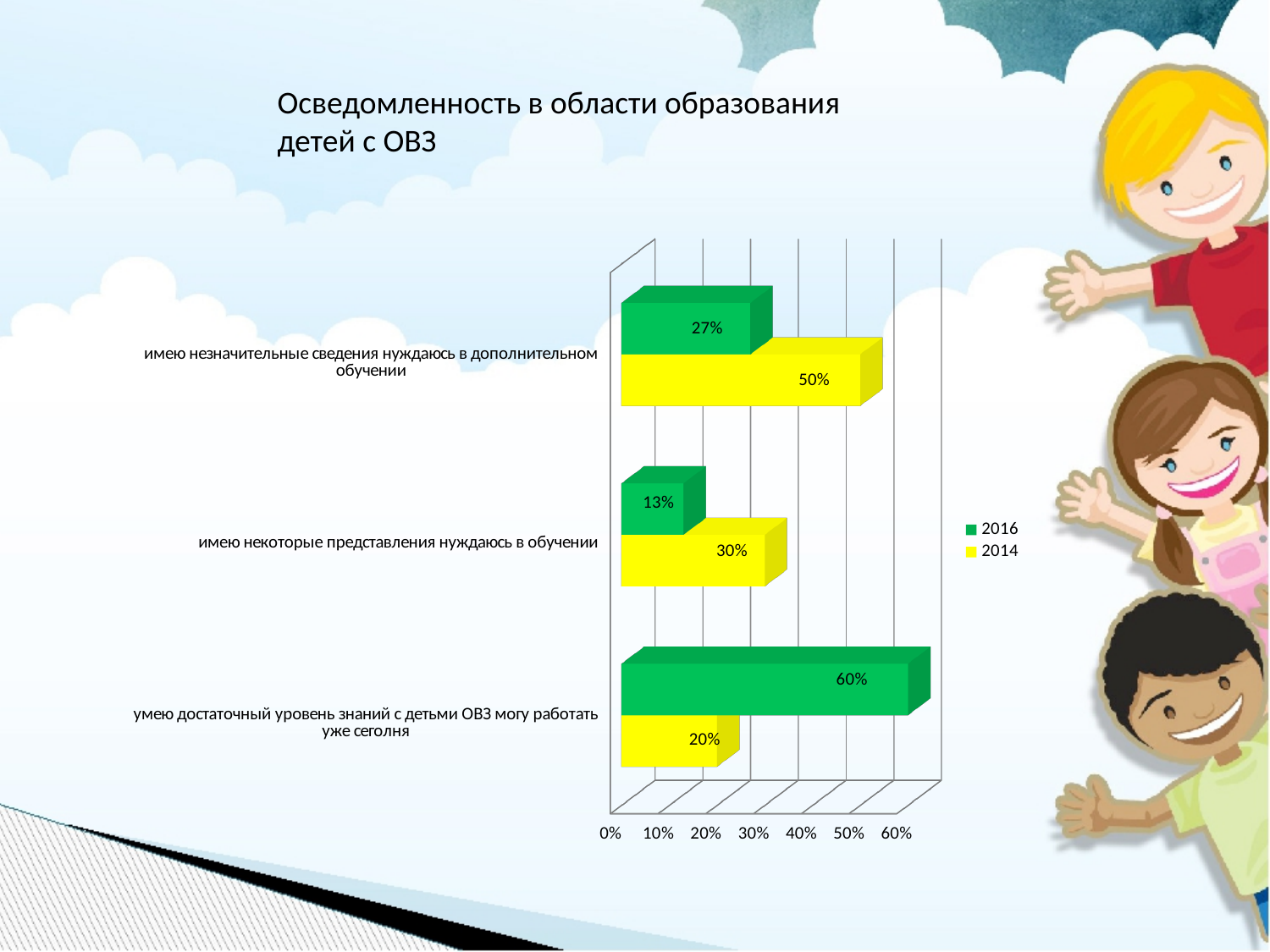
Which category has the highest 2016 value? умею достаточный уровень знаний с детьми ОВЗ могу работать уже сегодня What is the 2016 value for "умею достаточный уровень знаний с детьми ОВЗ могу работать уже сегодня"? 60% What is the 2016 value for "имею незначительные сведения нуждаюсь в дополнительном обучении"? 27% How many series does the legend list? 2 For "умею достаточный уровень знаний с детьми ОВЗ могу работать уже сегодня", which year has the larger value, 2016 or 2014? 2016 How many categories are shown on the chart? 3 What kind of chart is shown on the slide? Bar chart Which category has the lowest 2014 value? умею достаточный уровень знаний с детьми ОВЗ могу работать уже сегодня What is the 2014 value for "имею некоторые представления нуждаюсь в обучении"? 30% What is the 2014 value for "имею незначительные сведения нуждаюсь в дополнительном обучении"? 50% Which colour represents the 2014 series in the legend? Yellow What is the difference between the 2014 and 2016 values for "имею незначительные сведения нуждаюсь в дополнительном обучении"? 23%